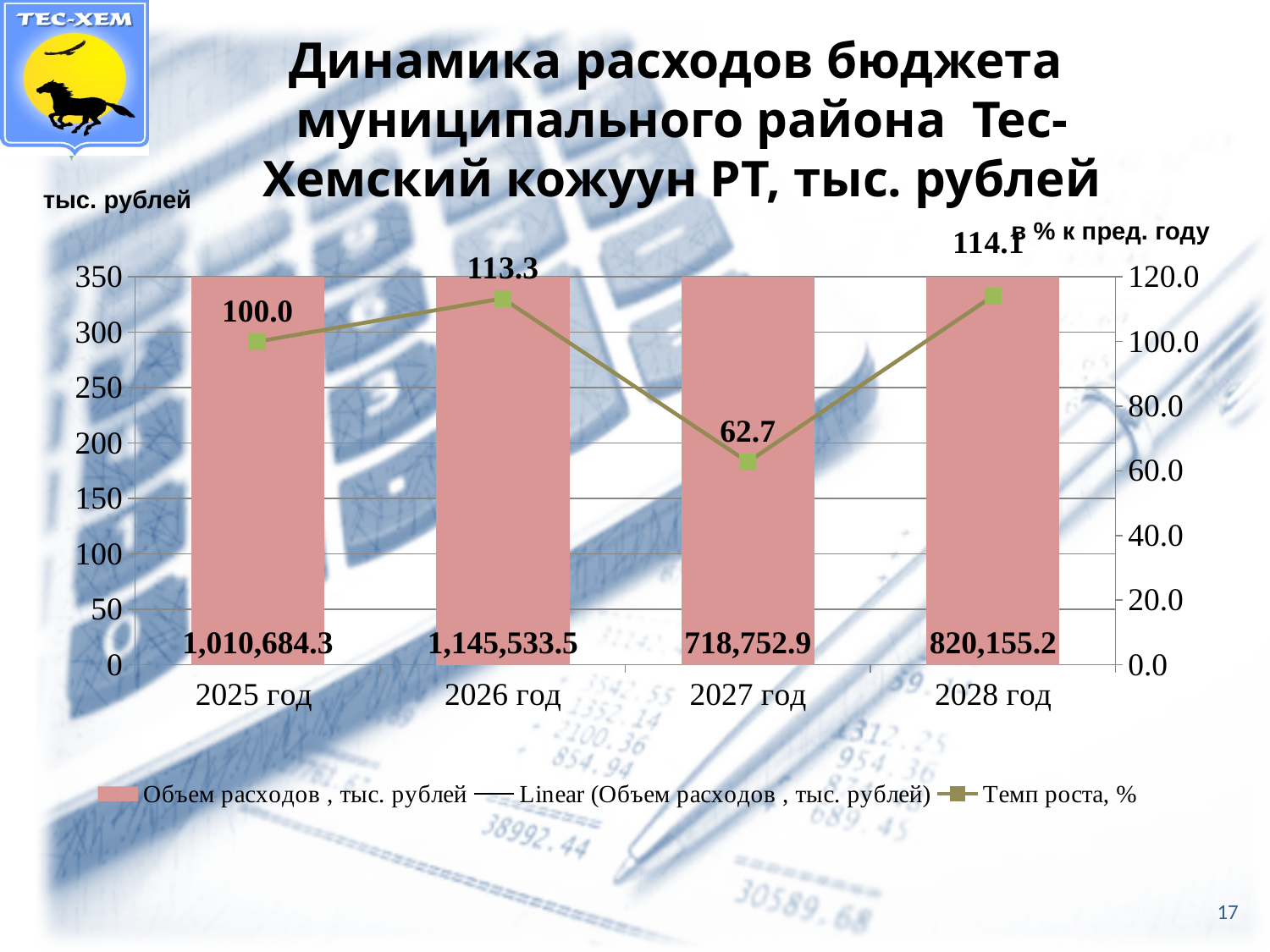
Which year has the highest Объем расходов according to the data labels? 2026 год What is the value of Объем расходов for 2025 год? 1,010,684.3 What is the value of Объем расходов for 2027 год? 718,752.9 How many years are shown on the x axis? 4 What kind of chart is this? Combined bar and line chart Which is larger, the Объем расходов for 2028 год or for 2027 год? 2028 год What is the difference between the Темп роста, % values for 2028 год and 2027 год? 51.4 What is the Темп роста, % value for 2026 год? 113.3 How many entries does the legend list? 3 Which year has the lowest Темп роста, %? 2027 год What is the label of the right-hand vertical axis? в % к пред. году What is the Темп роста, % value for 2028 год? 114.1